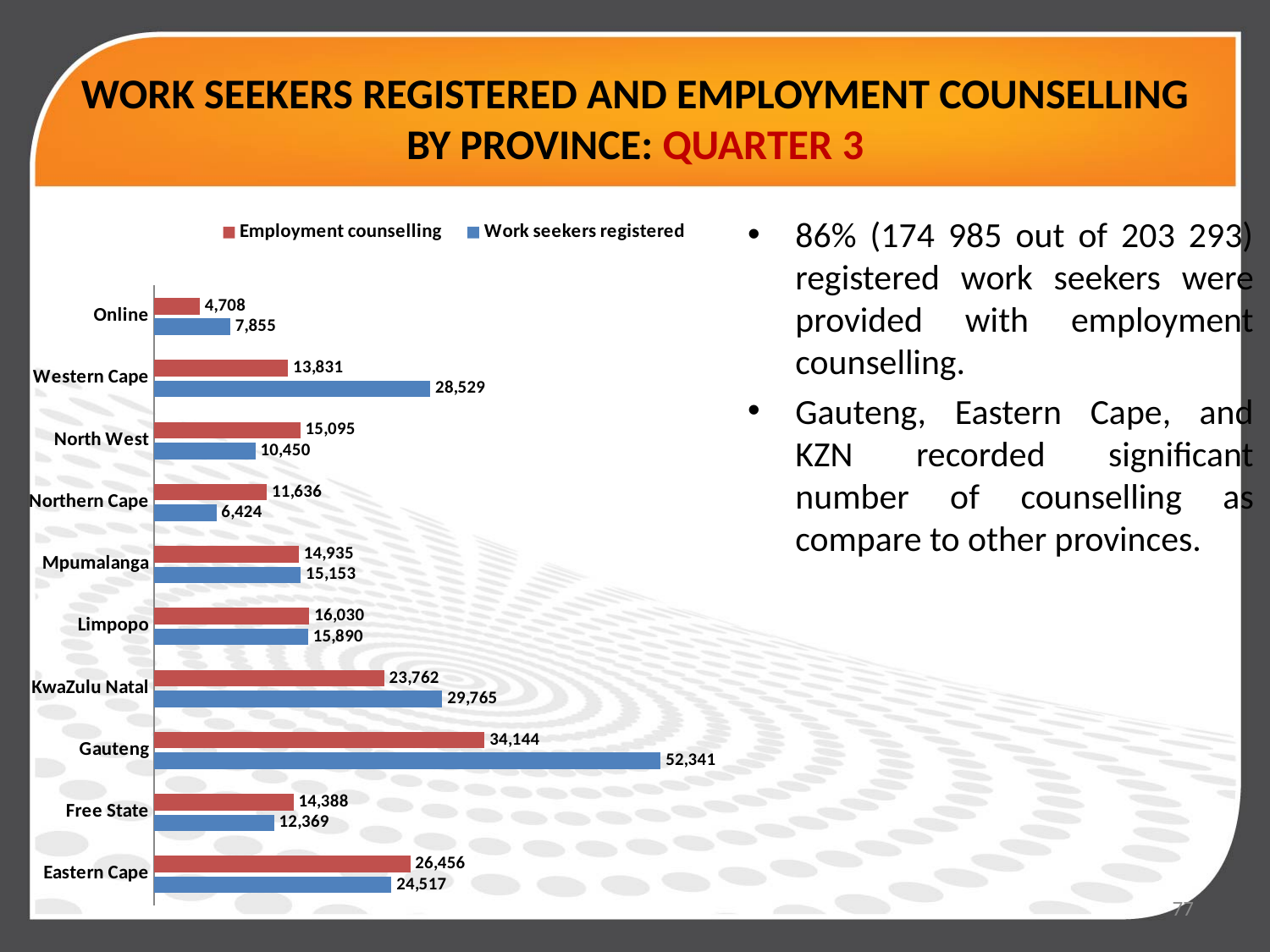
Which category has the highest number of work seekers registered? Gauteng What kind of chart is shown on the slide? Bar chart What is the difference between work seekers registered and employment counselling in Western Cape? 14,698 What is the employment counselling value for Online? 4,708 How many categories are shown on the chart? 10 Which is larger for North West: employment counselling or work seekers registered? Employment counselling What is the difference between Gauteng's work seekers registered and employment counselling values? 18,197 How many series does the legend list? 2 Which colour represents the Work seekers registered series? Blue What is the employment counselling value for KwaZulu Natal? 23,762 Which category has the lowest employment counselling value? Online What is the number of work seekers registered in Gauteng? 52,341